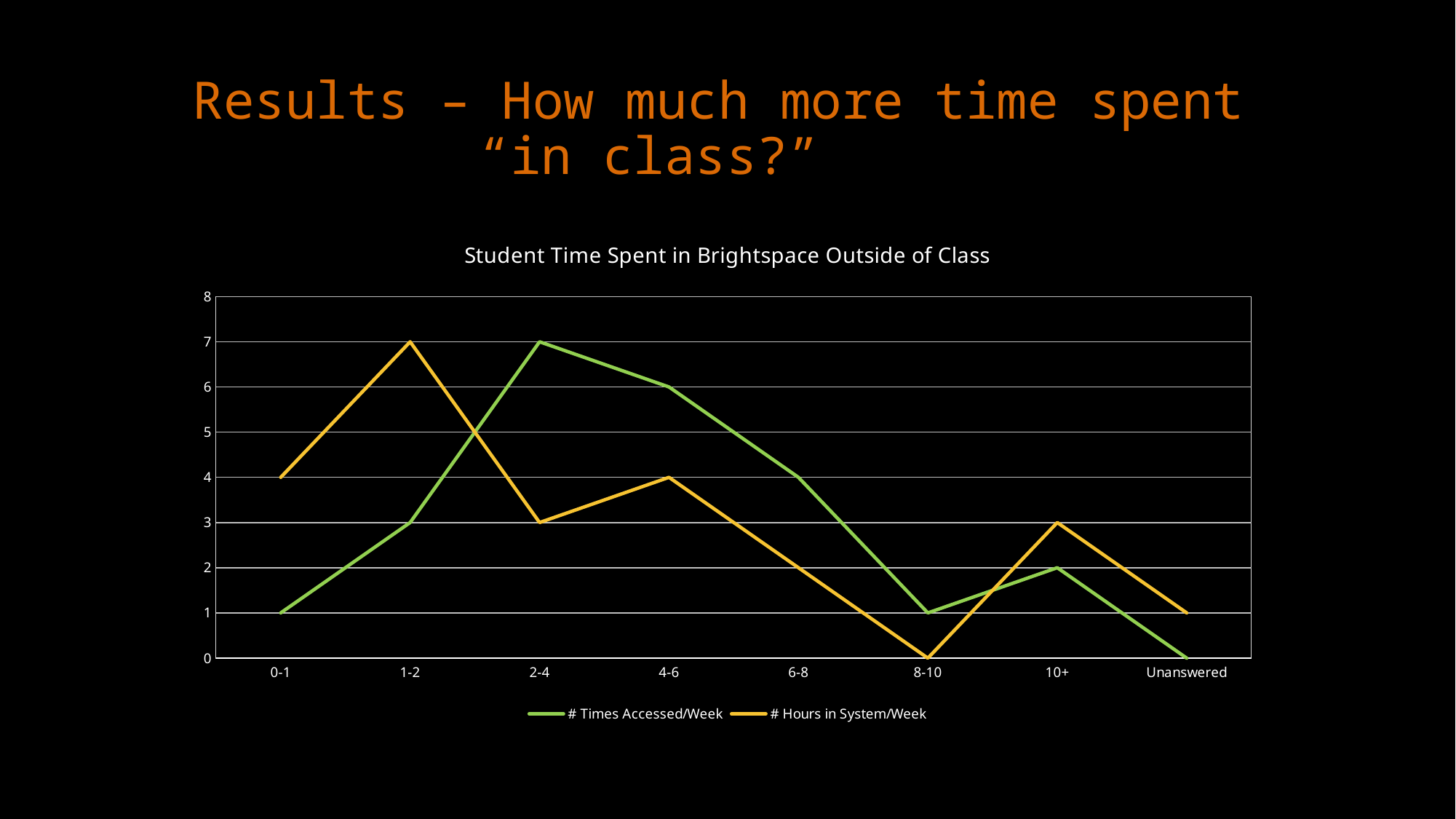
What is the title of the chart? Student Time Spent in Brightspace Outside of Class What is the difference between # Times Accessed/Week and # Hours in System/Week for the 2-4 category? 4 Which category has the lowest value for # Hours in System/Week? 8-10 What is the value of # Hours in System/Week for the 8-10 category? 0 Does # Times Accessed/Week rise or fall from 2-4 to 8-10? Fall How many categories are shown on the x axis? 8 Which category has the highest value for # Times Accessed/Week? 2-4 What kind of chart is shown on the slide? Line chart What is the value of # Times Accessed/Week for the 2-4 category? 7 For the 0-1 category, which series has the larger value, # Times Accessed/Week or # Hours in System/Week? # Hours in System/Week How many series does the legend list? 2 What is the value of # Hours in System/Week for the 1-2 category? 7